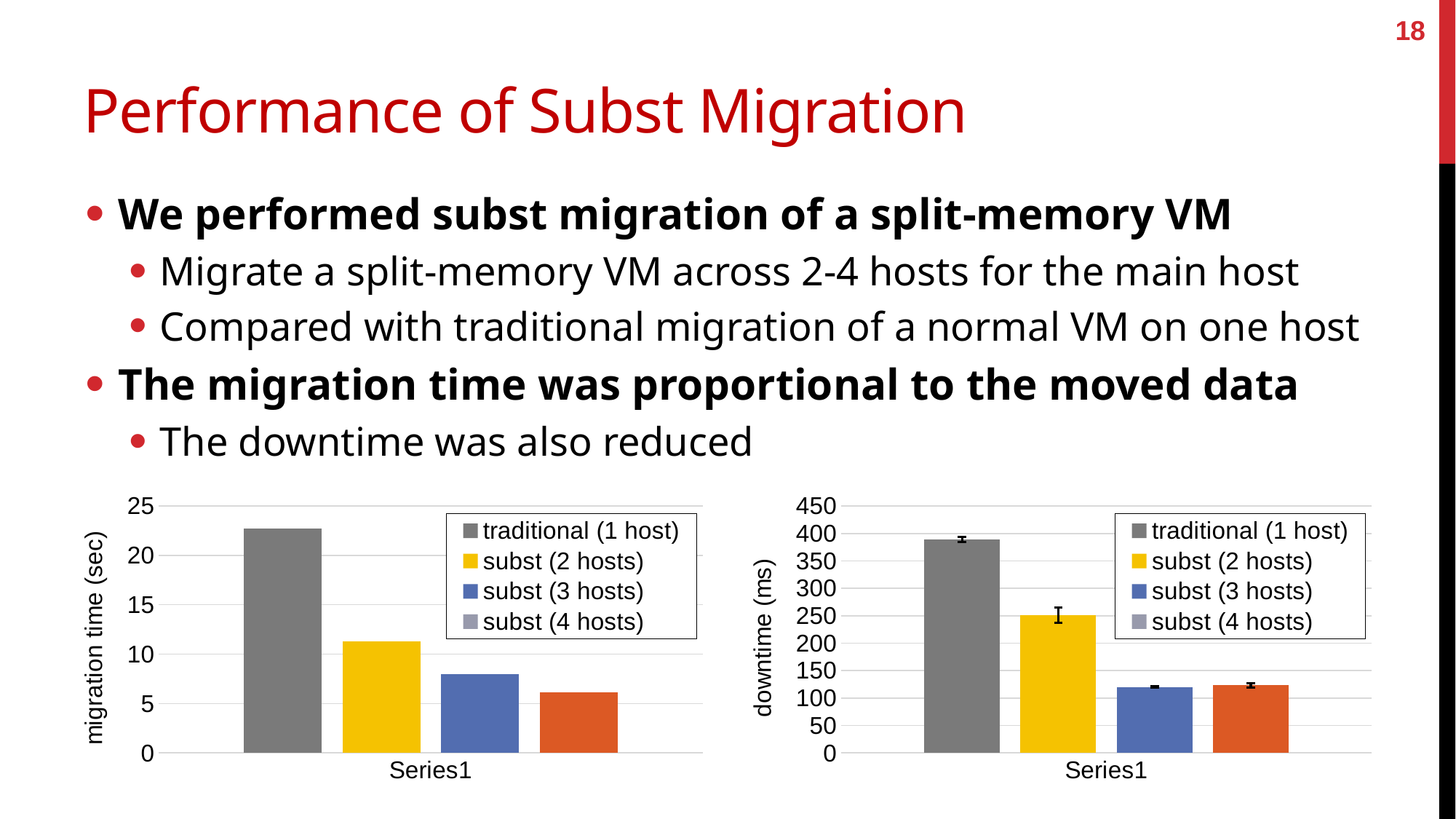
In the right chart (downtime), which series has the highest value? traditional (1 host) In the right chart (downtime), is the value for subst (2 hosts) greater or less than 200? greater In the left chart (migration time), is the value for traditional (1 host) greater or less than 20? greater In the left chart (migration time), which series has the lowest value? subst (4 hosts) How many series does the legend of the right chart (downtime) list? 4 What is the y-axis label of the right chart? downtime (ms) In the left chart (migration time), which series has the highest value? traditional (1 host) In the left chart (migration time), do the bar values rise or fall from left to right? fall In the left chart (migration time), is the value for subst (3 hosts) greater or less than 10? less In the right chart (downtime), which is larger, traditional (1 host) or subst (2 hosts)? traditional (1 host) What kind of chart is the left chart (migration time)? bar chart